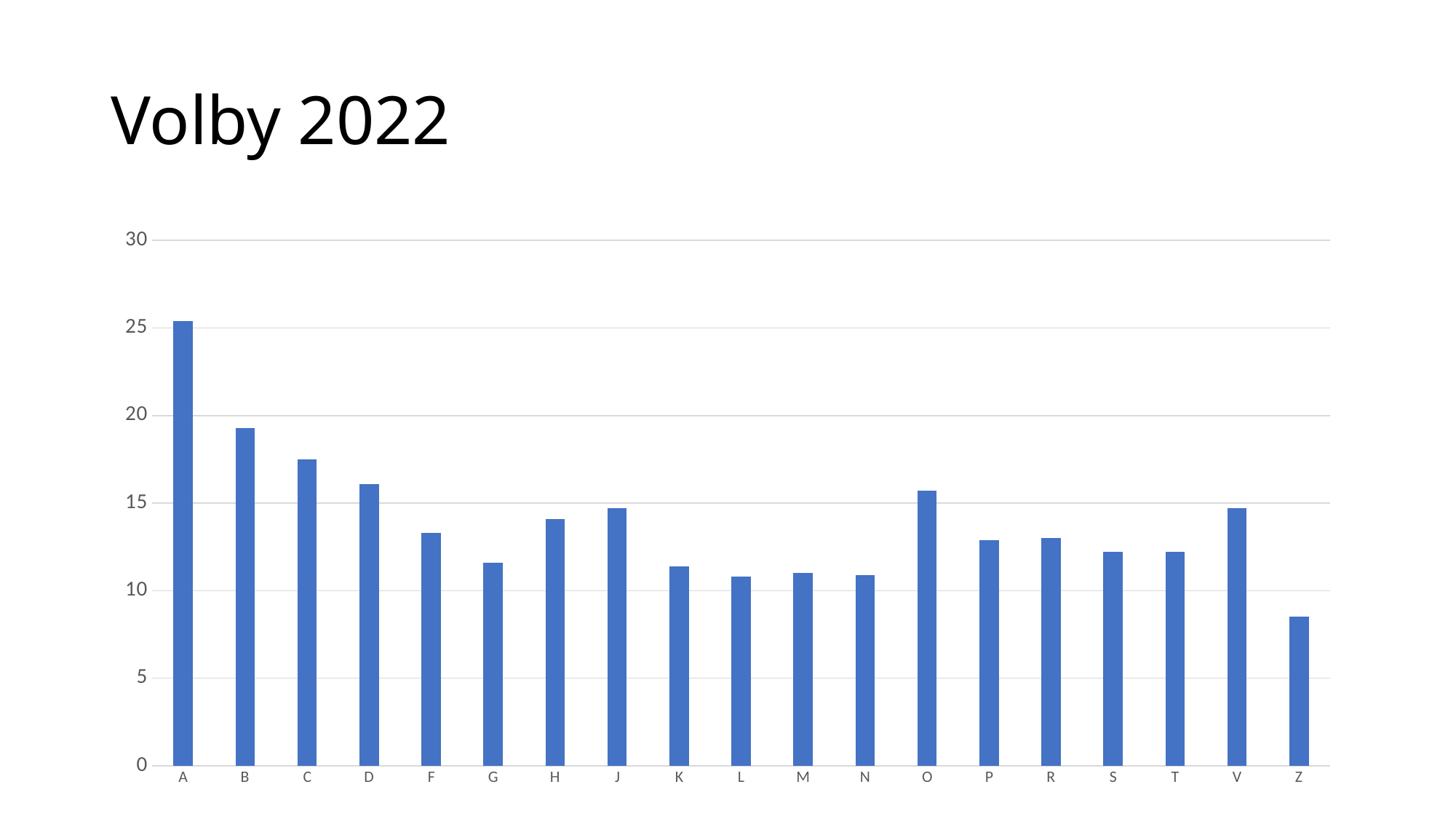
Is the value for G greater or less than 10? greater Is the value for B greater or less than 20? less Is the value for O greater or less than 15? greater Which category has the lowest bar in the chart? Z How many categories are shown on the x axis of the chart? 19 Which is larger, the value for B or the value for C? B Which category has the highest bar in the chart? A Which is larger, the value for O or the value for P? O What is the title shown above the chart on the slide? Volby 2022 What kind of chart is shown on the slide? bar chart